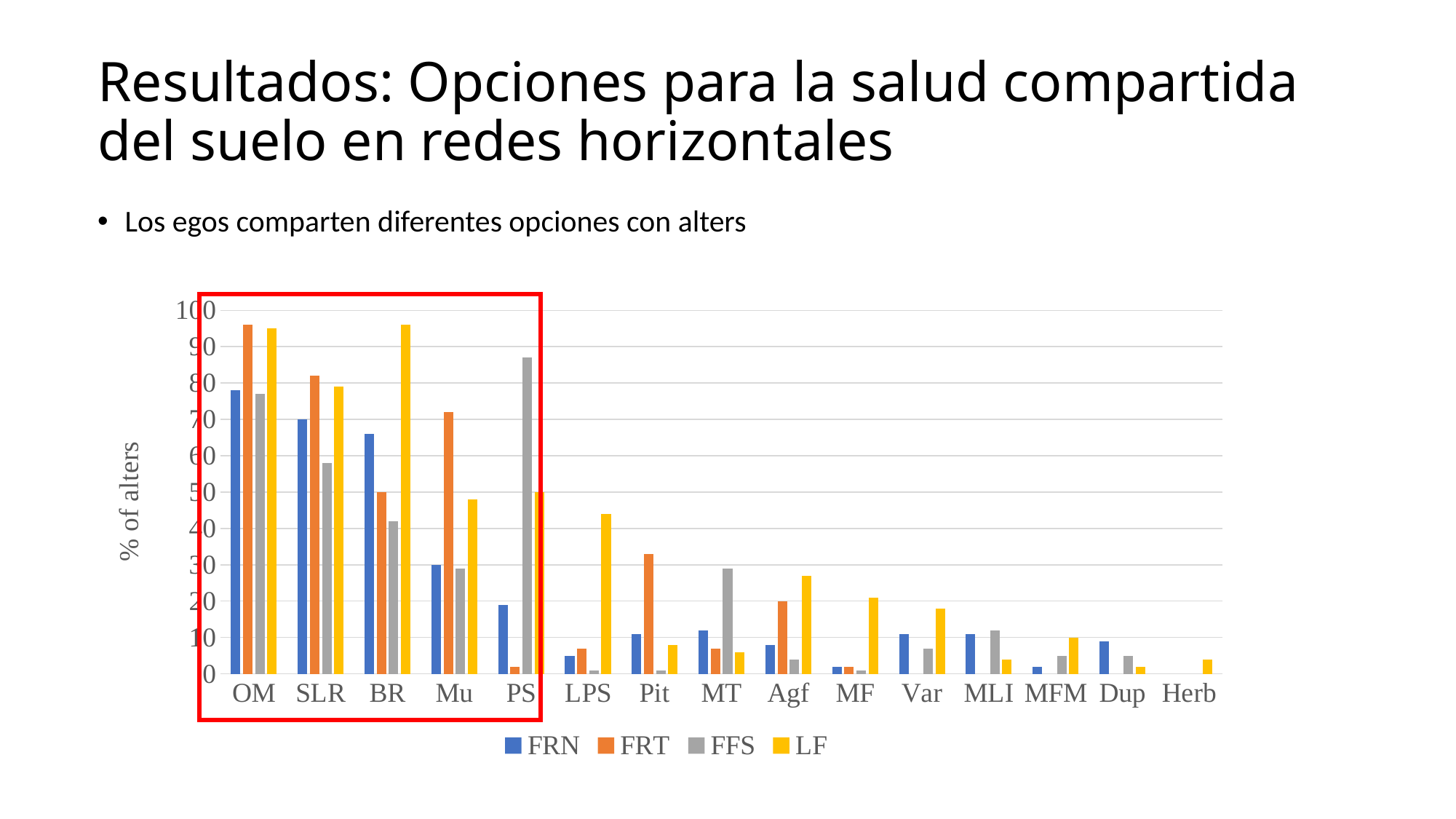
Is the LF value for LPS greater or less than 30? greater Which series has the highest value for PS? FFS Which is larger, the FRT value for SLR or the FRT value for BR? SLR What kind of chart is shown on the slide? bar chart How many categories are shown on the x axis? 15 Which series has the highest value for BR? LF How many series does the legend list? 4 Is the FFS value for PS greater or less than 80? greater What is the label on the y axis? % of alters Is the FRT value for Mu greater or less than 60? greater